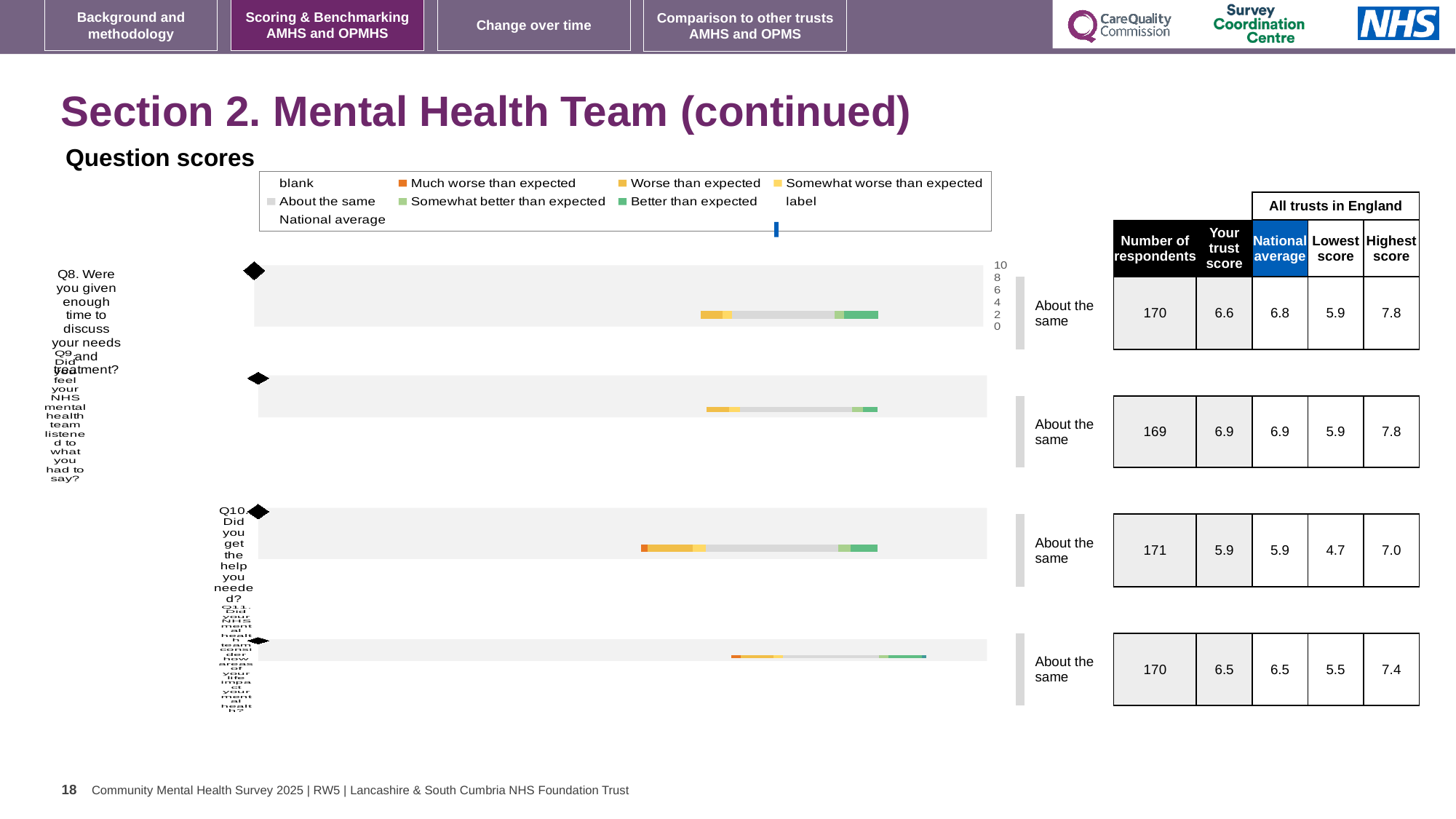
What is the Lowest score shown for Q10 (Did you get the help you needed?)? 4.7 How many respondents are shown for Q9 (Did you feel your NHS mental health team listened to what you had to say?)? 169 How many questions (Q8 to Q11) are plotted on the slide? 4 What is the Highest score shown for Q11? 7.4 Which question has the highest 'Your trust score' on the slide? Q9 What is the 'Your trust score' value shown for Q8 (Were you given enough time to discuss your needs and treatment?)? 6.6 For Q8, which is larger: the trust score or the National average? National average What comparison label is shown next to each of the four question bars? About the same What is the National average shown for Q8? 6.8 What kind of chart is used to show the question scores on this slide? bar chart What is the difference between the Highest score and the Lowest score for Q10? 2.3 Which question has the lowest 'Your trust score' on the slide? Q10